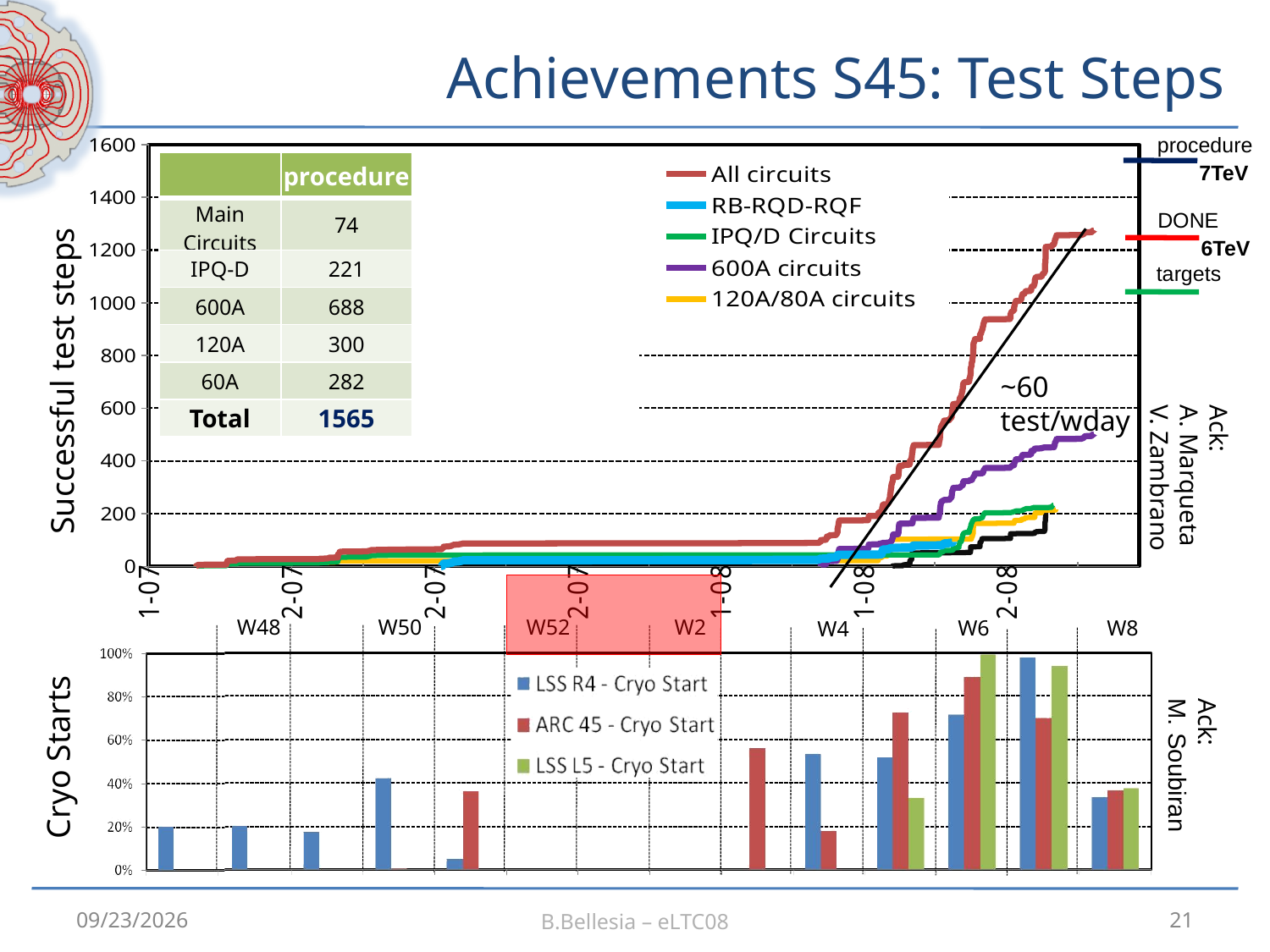
In the top chart (Successful test steps), is the final value of the 600A circuits line greater or less than 400? greater In the top chart (Successful test steps), does the All circuits line rise or fall along the x axis? rise How many series does the legend of the bottom chart (Cryo Starts) list? 3 How many series does the legend of the top chart (Successful test steps) list? 5 In the bottom chart (Cryo Starts), is the LSS R4 - Cryo Start value at W6 greater or less than 60%? greater In the top chart (Successful test steps), which ends higher: the 600A circuits line or the IPQ/D Circuits line? 600A circuits In the top chart (Successful test steps), is the final value of the All circuits line greater or less than 1200? greater In the table on the top chart, what is the Total procedure value? 1565 What kind of chart is the top chart showing successful test steps? line chart What kind of chart is the bottom chart showing Cryo Starts? bar chart In the table on the top chart, what is the procedure value for 600A? 688 In the top chart (Successful test steps), which series reaches the highest value at the right end? All circuits